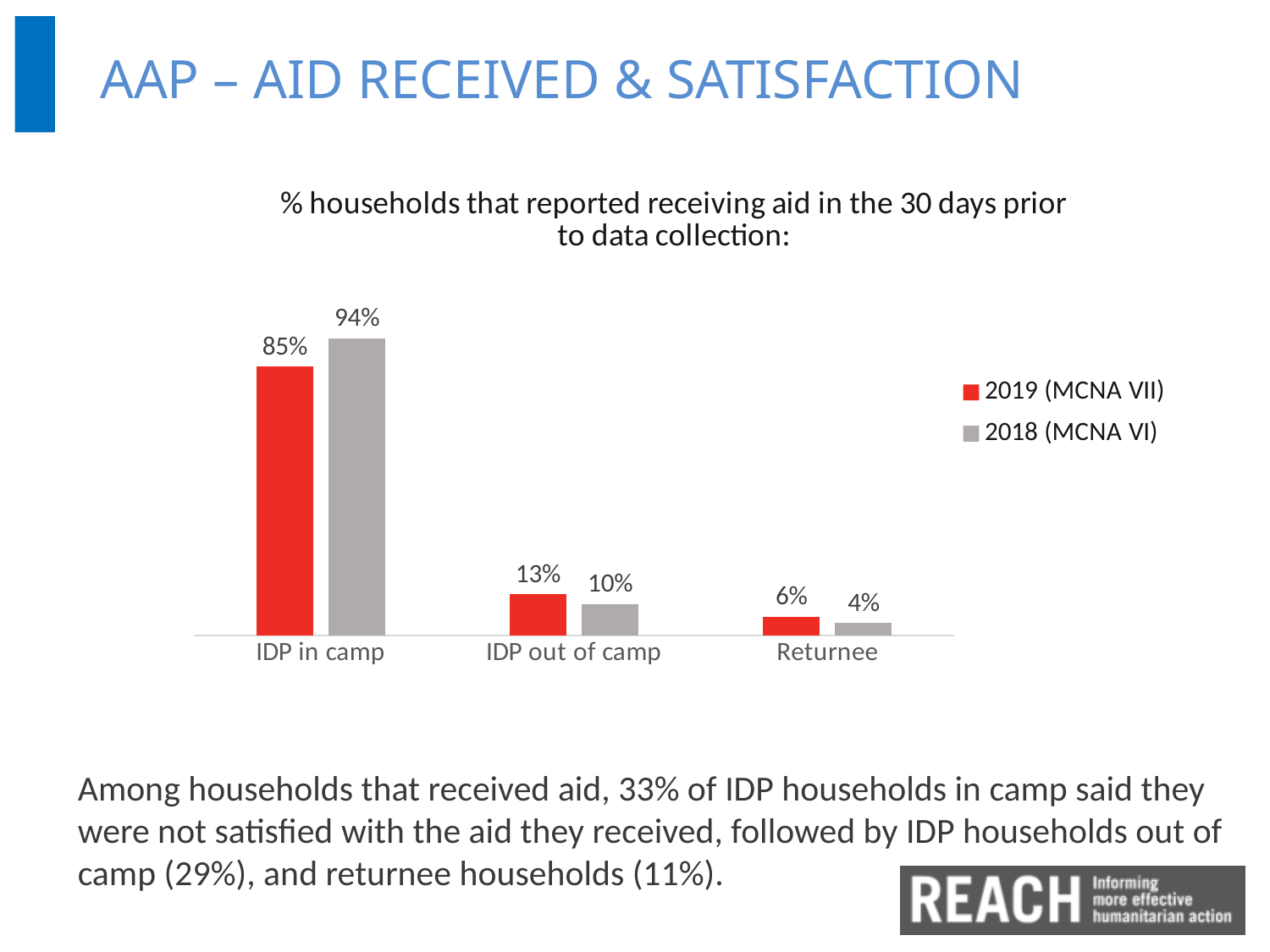
Which population group has the lowest share of households reporting aid received in 2018 (MCNA VI)? Returnee How many series does the chart legend list? 2 What is the 2019 (MCNA VII) value for IDP out of camp? 13% How many population groups are shown on the x axis of the chart? 3 For IDP out of camp, which year has the larger value, 2019 (MCNA VII) or 2018 (MCNA VI)? 2019 (MCNA VII) What is the difference between the 2018 (MCNA VI) and 2019 (MCNA VII) values for IDP in camp? 9 percentage points What type of chart is used to show the % of households that reported receiving aid? Bar chart Which colour represents the 2019 (MCNA VII) series in the chart? Red What is the 2018 (MCNA VI) value for Returnee? 4% Which population group has the highest share of households reporting aid received in 2019 (MCNA VII)? IDP in camp What percentage of IDP in camp households reported receiving aid in 2019 (MCNA VII)? 85% What percentage of IDP in camp households reported receiving aid in 2018 (MCNA VI)? 94%